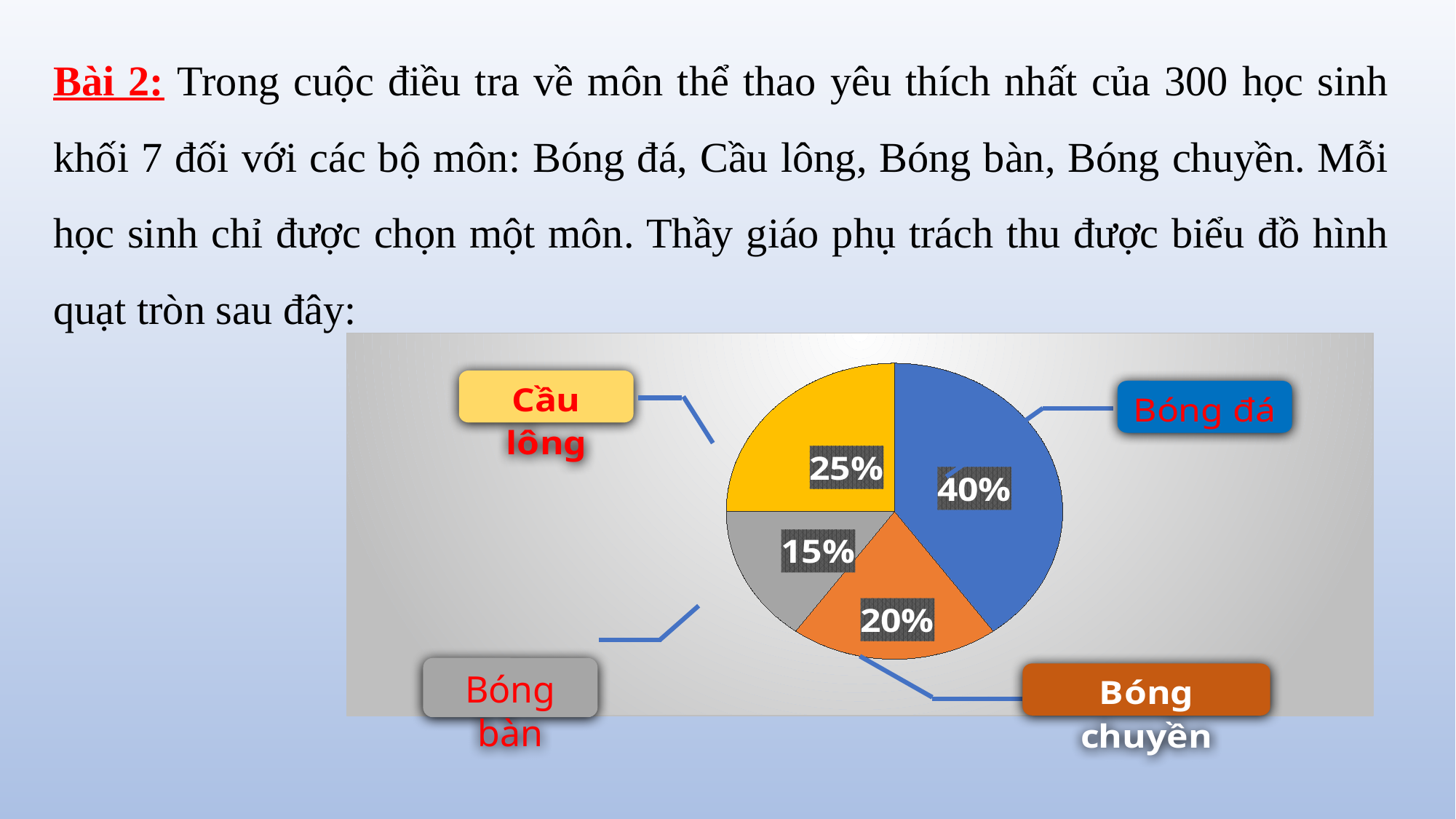
What is the difference in percentage points between Bóng đá and Bóng bàn? 25 What percentage of students chose Bóng bàn? 15% What kind of chart is shown on the slide? Pie chart What percentage of students chose Bóng chuyền? 20% Which has a larger share, Cầu lông or Bóng chuyền? Cầu lông How many sports are shown in the pie chart? 4 Which sport has the smallest share of the pie? Bóng bàn What percentage of students chose Bóng đá? 40% What colour is the Bóng chuyền slice? Orange What percentage of students chose Cầu lông? 25% What colour is the Cầu lông slice? Yellow Which sport has the largest share of the pie? Bóng đá